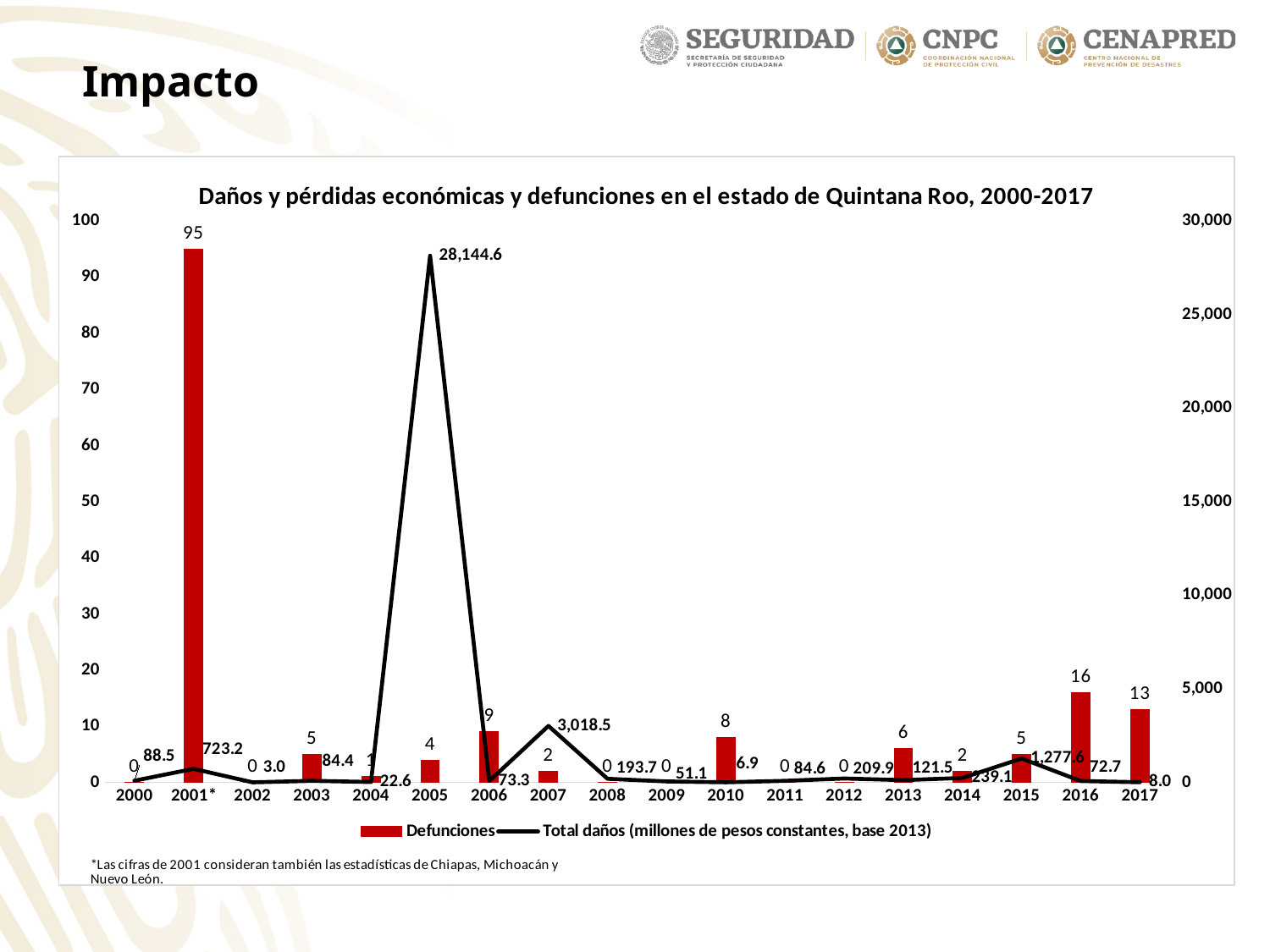
What is the Total daños value for 2007? 3,018.5 Which year has more Defunciones, 2006 or 2010? 2006 How many series does the legend list? 2 Which year has the highest Total daños value? 2005 What is the Total daños value for 2005? 28,144.6 What colour are the Defunciones bars? Red How many years are shown on the x axis? 18 Is the Total daños value for 2005 greater or less than 25,000? greater What is the number of Defunciones in 2001*? 95 What is the difference in Defunciones between 2016 and 2017? 3 Which year has the highest number of Defunciones? 2001* What is the number of Defunciones in 2016? 16